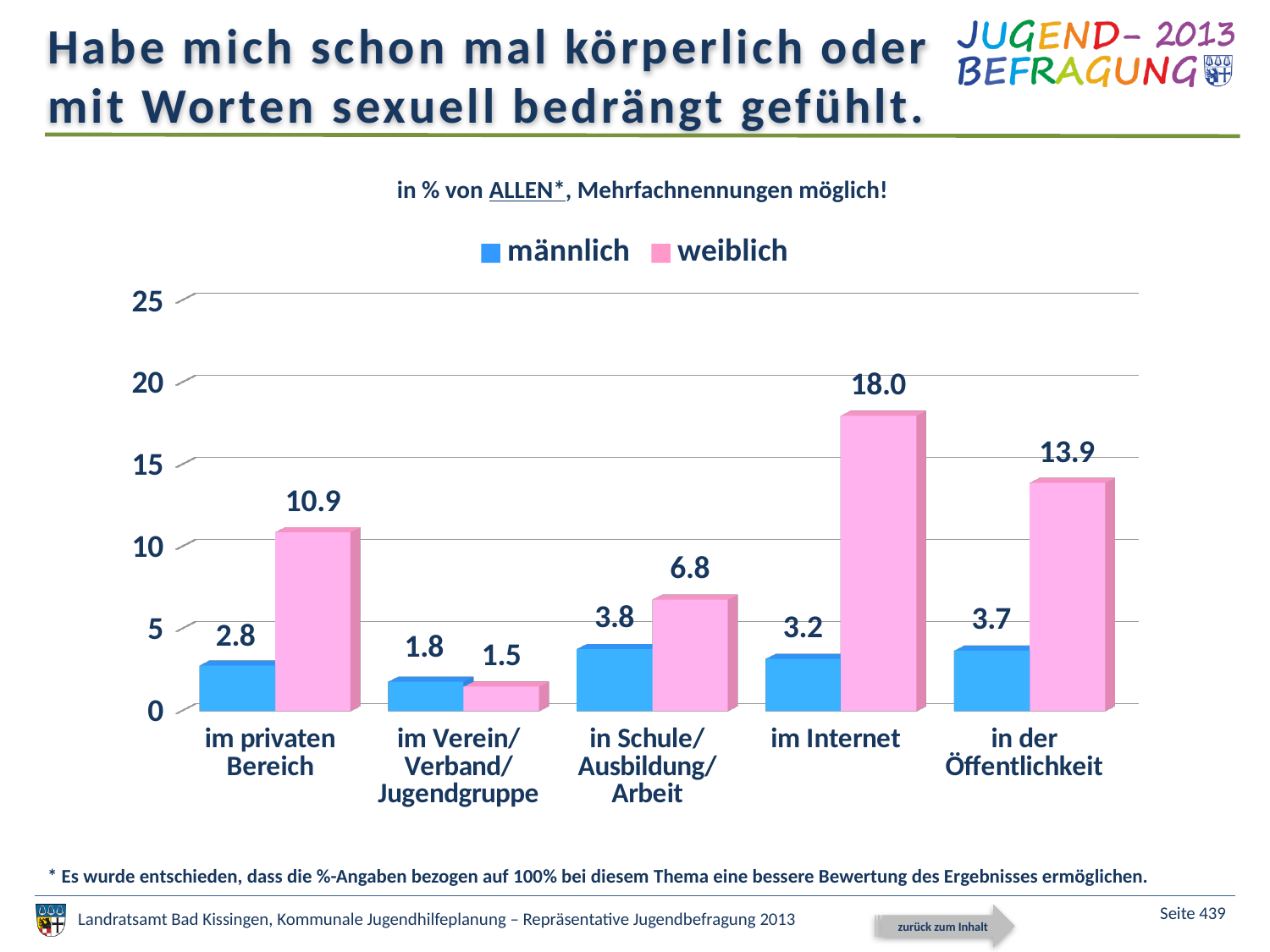
What is the difference between the weiblich and männlich values in the category 'im Internet'? 14.8 Which is larger in the category 'im Verein/ Verband/ Jugendgruppe': the männlich value or the weiblich value? männlich What is the value for weiblich in the category 'im Internet'? 18.0 What kind of chart is shown on the slide? bar chart How many series does the legend list? 2 How many categories are shown on the x axis? 5 What is the value for männlich in the category 'im privaten Bereich'? 2.8 Which colour represents the series 'weiblich' in the legend? pink What is the value for weiblich in the category 'in der Öffentlichkeit'? 13.9 Is the value for weiblich in 'im privaten Bereich' greater or less than 10? greater Which category has the highest value for weiblich? im Internet Which category has the lowest value for männlich? im Verein/ Verband/ Jugendgruppe